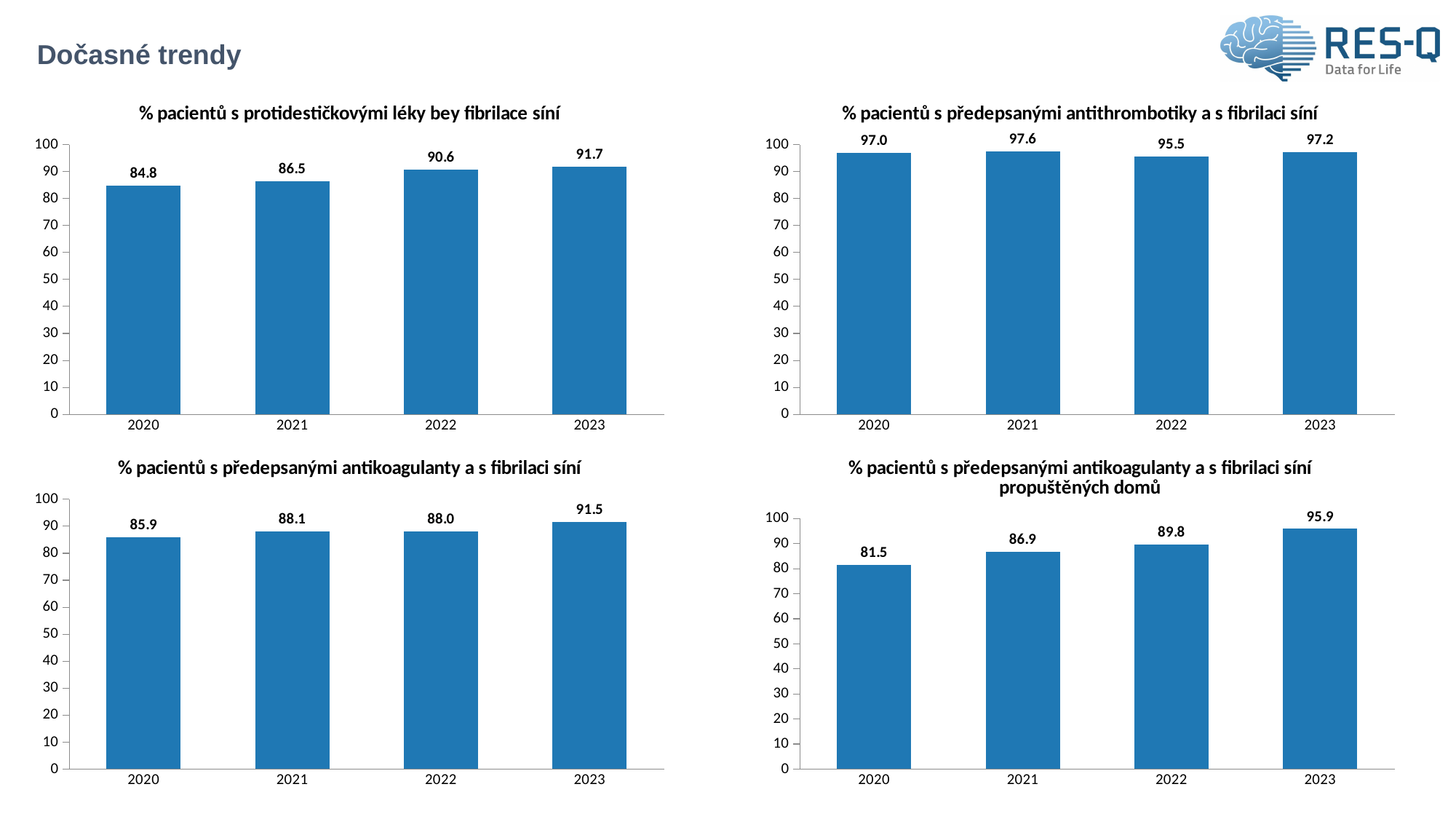
In the bottom-right chart (% pacientů s předepsanými antikoagulanty a s fibrilaci síní propuštěných domů), what is the difference between the 2023 and 2020 values? 14.4 In the top-right chart (% pacientů s předepsanými antithrombotiky a s fibrilaci síní), which year has the lowest value? 2022 How many years are shown on the x axis of the top-left chart (% pacientů s protidestičkovými léky bey fibrilace síní)? 4 In the bottom-right chart (% pacientů s předepsanými antikoagulanty a s fibrilaci síní propuštěných domů), do the values rise or fall from 2020 to 2023? rise In the top-left chart (% pacientů s protidestičkovými léky bey fibrilace síní), which year has the highest value? 2023 In the top-right chart (% pacientů s předepsanými antithrombotiky a s fibrilaci síní), what is the value for 2022? 95.5 In the bottom-right chart (% pacientů s předepsanými antikoagulanty a s fibrilaci síní propuštěných domů), what is the value for 2021? 86.9 In the bottom-left chart (% pacientů s předepsanými antikoagulanty a s fibrilaci síní), which year has the lowest value? 2020 In the top-right chart (% pacientů s předepsanými antithrombotiky a s fibrilaci síní), what is the difference between the 2021 and 2022 values? 2.1 In the top-left chart (% pacientů s protidestičkovými léky bey fibrilace síní), what is the value for 2020? 84.8 In the bottom-left chart (% pacientů s předepsanými antikoagulanty a s fibrilaci síní), what is the value for 2023? 91.5 What kind of chart is the bottom-left chart (% pacientů s předepsanými antikoagulanty a s fibrilaci síní)? bar chart